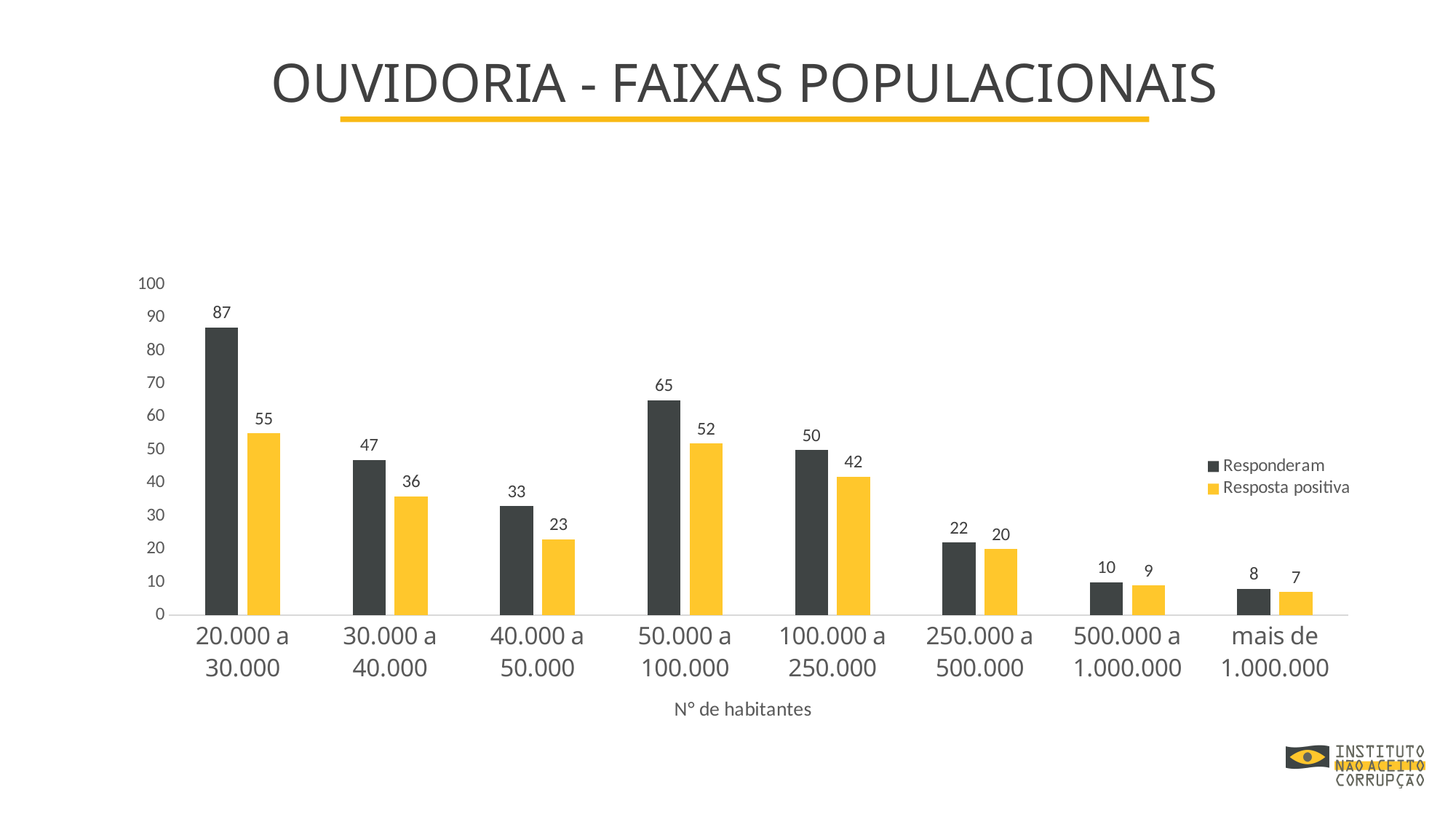
What is the value of Responderam for the 20.000 a 30.000 category? 87 What kind of chart is shown on the slide? Bar chart Which category has the lowest Resposta positiva value? mais de 1.000.000 How many population categories are shown on the x axis? 8 How many series does the legend list? 2 What is the difference between the Responderam values for 50.000 a 100.000 and 40.000 a 50.000? 32 What is the difference between Responderam and Resposta positiva for the 20.000 a 30.000 category? 32 Which category has the highest Responderam value? 20.000 a 30.000 What is the value of Resposta positiva for the mais de 1.000.000 category? 7 What is the x-axis title of the chart? N° de habitantes Which is larger: Responderam for 30.000 a 40.000 or Responderam for 100.000 a 250.000? 100.000 a 250.000 What is the value of Resposta positiva for the 100.000 a 250.000 category? 42